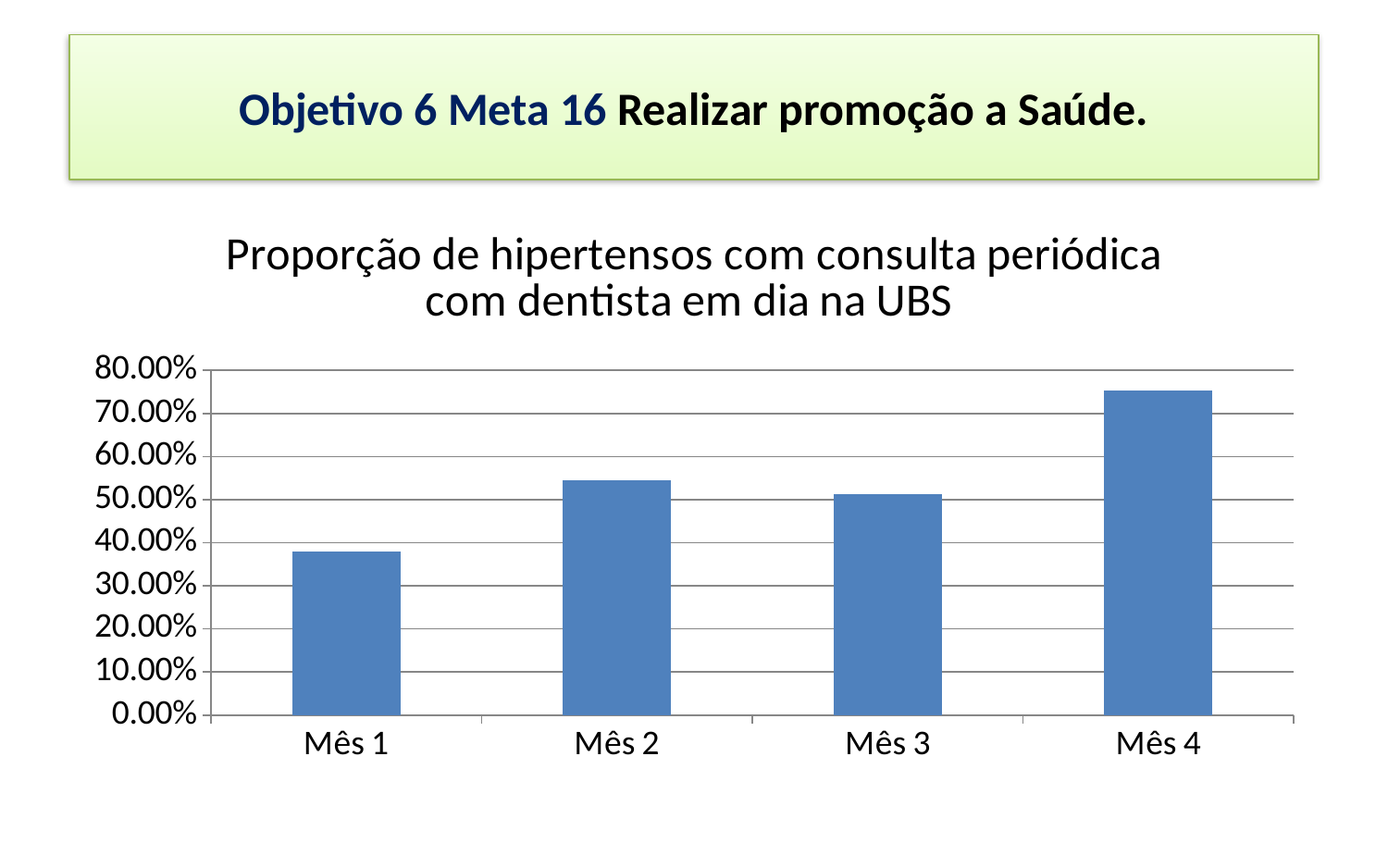
Is the value for Mês 2 greater or less than 50.00%? greater Is the value for Mês 4 greater or less than 70.00%? greater Which month has the highest proportion? Mês 4 Overall, does the proportion rise or fall from Mês 1 to Mês 4? Rise Is the value for Mês 3 greater or less than 60.00%? less Which is larger, the value for Mês 4 or the value for Mês 1? Mês 4 What is the title of the chart? Proporção de hipertensos com consulta periódica com dentista em dia na UBS What kind of chart is shown on the slide? Bar chart Which month has the lowest proportion? Mês 1 Which is larger, the value for Mês 2 or the value for Mês 1? Mês 2 How many months (categories) are plotted on the x axis? 4